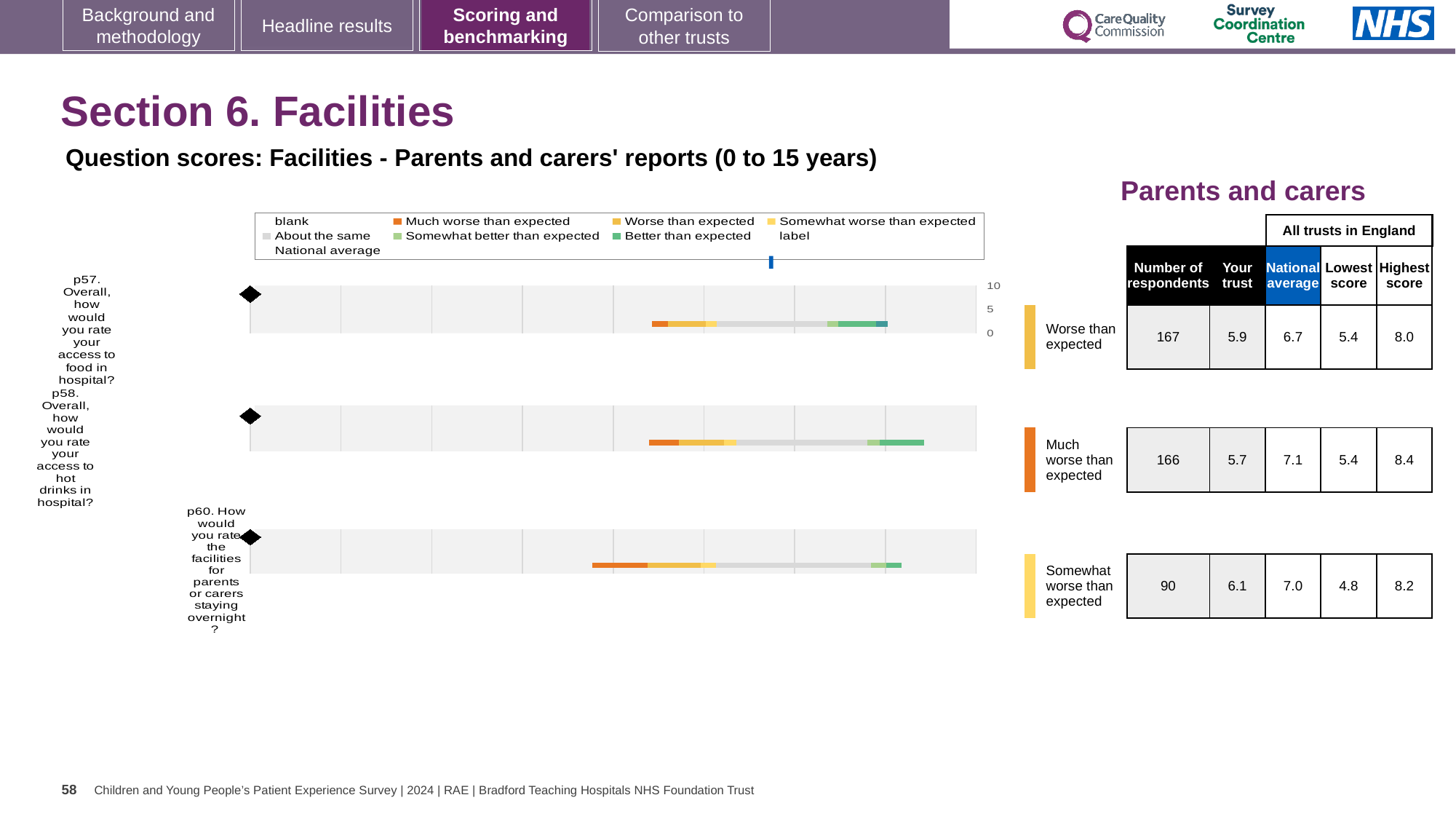
For p57, which is larger: the 'Your trust' score or the national average? National average What is the highest score across all trusts in England for p58? 8.4 Which of the three questions has the highest 'Your trust' score? p60 Which benchmark category is p58 (access to hot drinks) rated as? Much worse than expected What is the 'Your trust' score for p57 (access to food in hospital)? 5.9 How many respondents answered p60 (facilities for parents or carers staying overnight)? 90 Is the 'Your trust' score for p57 greater or less than 5 on the chart axis? greater How many questions (p57, p58, p60) are plotted in the chart area? 3 Which question has the lowest number of respondents? p60 What is the national average score for p58 (access to hot drinks in hospital)? 7.1 What kind of chart is used to show the question scores on this slide? bar chart What is the difference between the national average and the 'Your trust' score for p58? 1.4